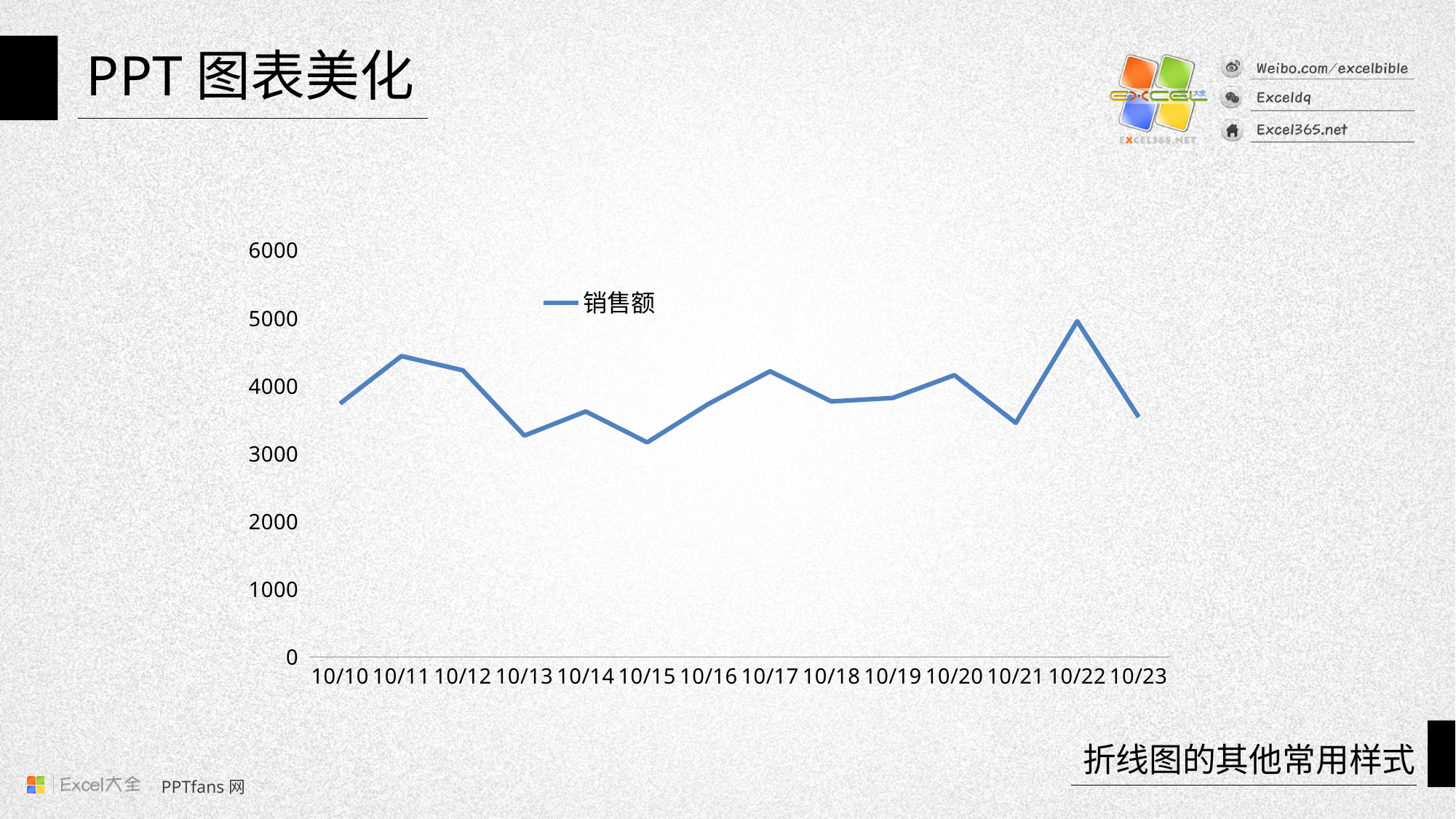
Is the value for 10/15 greater or less than 4000? less What is the name of the series shown in the legend? 销售额 Is the value for 10/13 greater or less than 3000? greater Does the line rise or fall from 10/22 to 10/23? fall Is the value for 10/11 greater or less than 4000? greater How many dates are shown on the x axis? 14 What kind of chart is shown on the slide? line chart Which has the larger value, 10/22 or 10/23? 10/22 How many series does the legend list? 1 Which has the larger value, 10/11 or 10/13? 10/11 On which date is the 销售额 value highest? 10/22